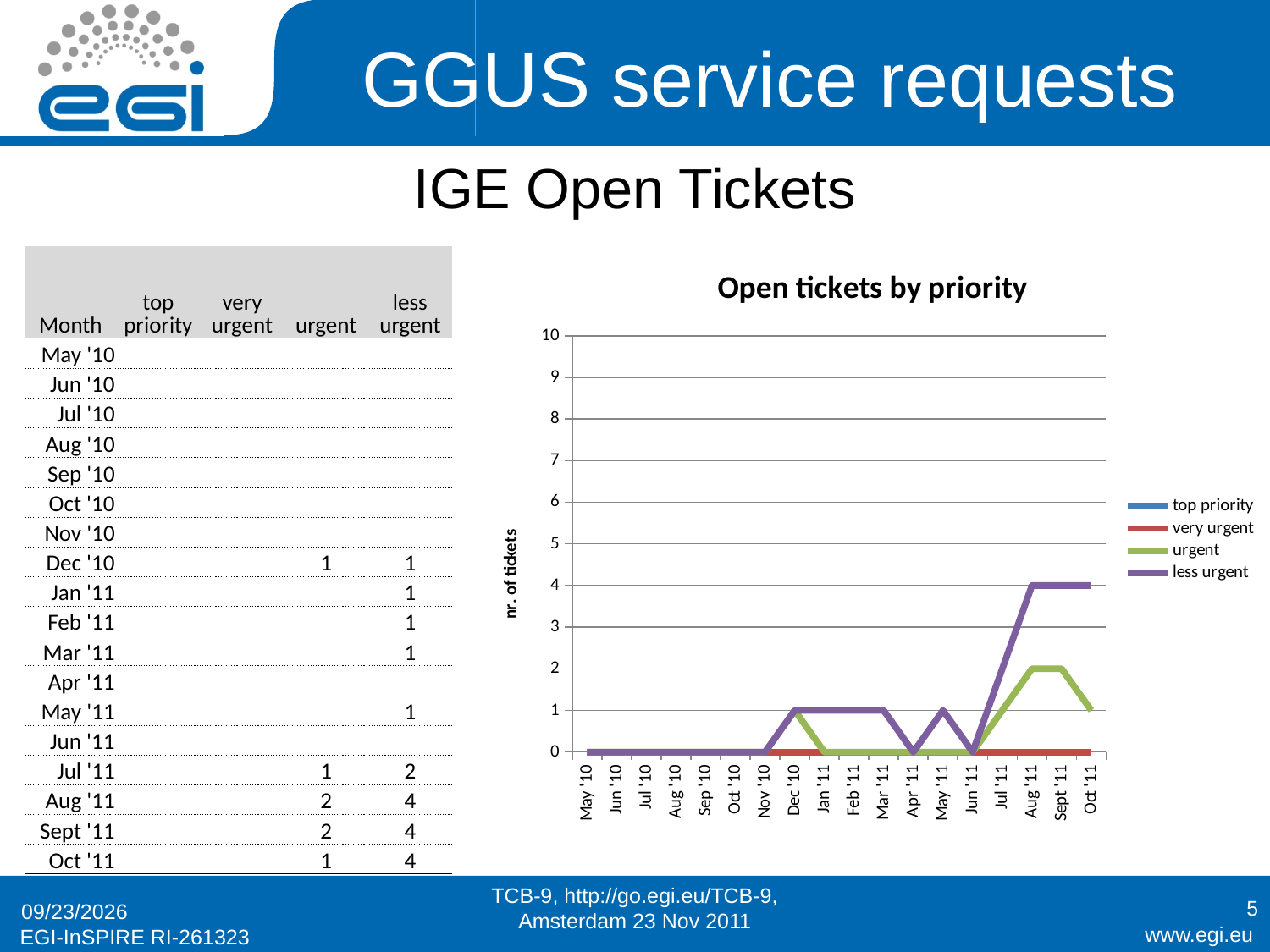
In the 'Open tickets by priority' chart, does the 'less urgent' series rise or fall from Jun '11 to Aug '11? rise Which series reaches the highest value in the 'Open tickets by priority' chart? less urgent In the 'Open tickets by priority' chart, what is the value for 'urgent' in Sept '11? 2 How many months are shown on the x axis of the 'Open tickets by priority' chart? 18 In the 'Open tickets by priority' chart, what is the difference between 'less urgent' and 'urgent' in Oct '11? 3 How many series does the legend of the 'Open tickets by priority' chart list? 4 What kind of chart is 'Open tickets by priority'? line chart In the 'Open tickets by priority' chart, is the value for 'less urgent' in Sept '11 greater or less than 3? greater In the 'Open tickets by priority' chart, what is the value for 'less urgent' in Aug '11? 4 In the 'Open tickets by priority' chart, which is larger in Aug '11: 'less urgent' or 'urgent'? less urgent What is the y-axis label of the 'Open tickets by priority' chart? nr. of tickets In the 'Open tickets by priority' chart, what is the value for 'urgent' in Dec '10? 1